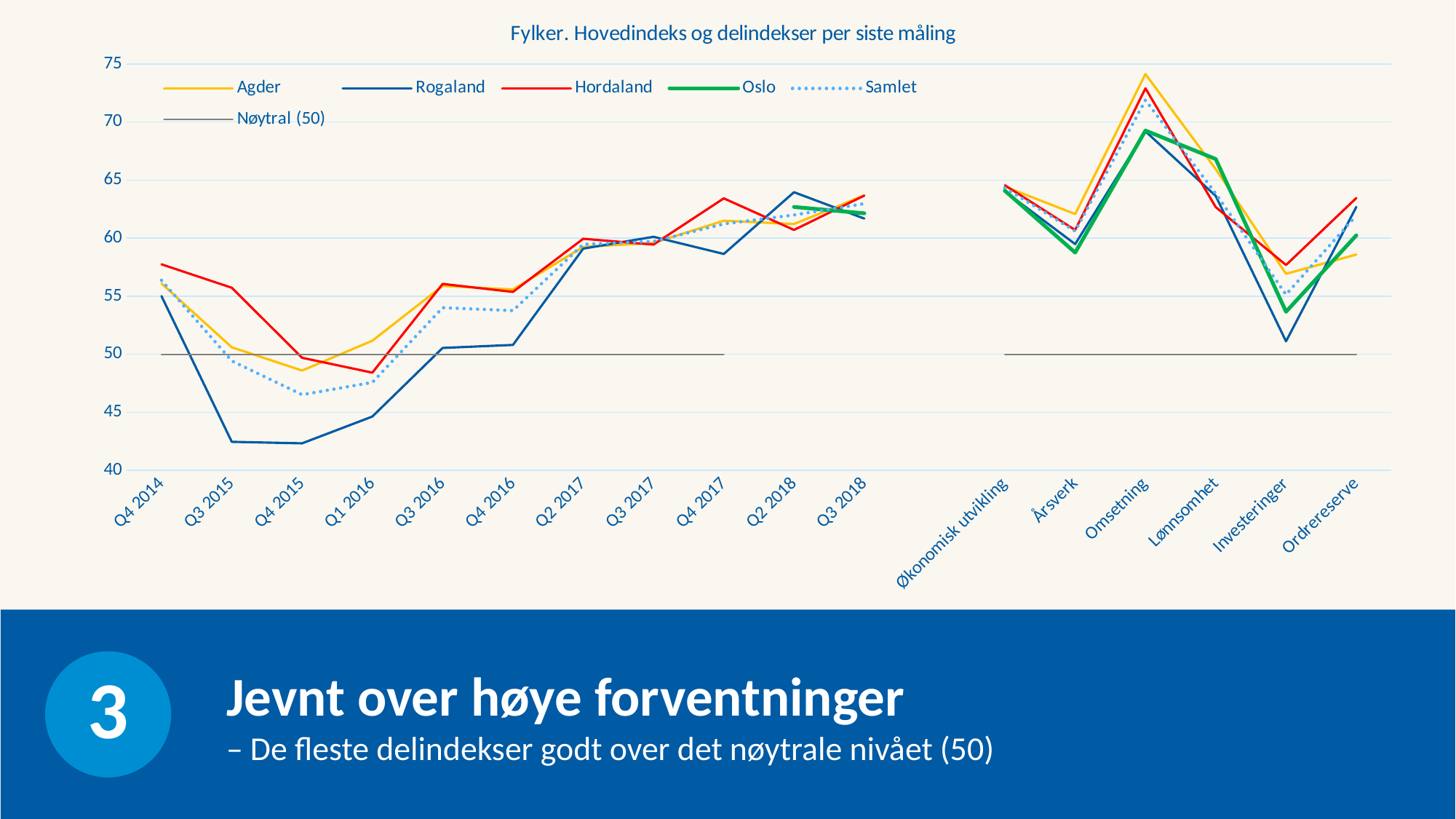
Is the value for Agder at Q4 2015 greater or less than 50? less What kind of chart is shown on the slide? line chart What is the title of the chart? Fylker. Hovedindeks og delindekser per siste måling At what level is the Nøytral line drawn? 50 Is the value for Rogaland at Q3 2015 greater or less than 45? less How many series does the legend list? 6 Is the value for Agder at Omsetning greater or less than 70? greater Which series has the highest value at Omsetning? Agder Does the Rogaland line rise or fall from Q4 2014 to Q3 2015? fall Which series has the lowest value at Q3 2015? Rogaland How many categories are shown along the x axis? 17